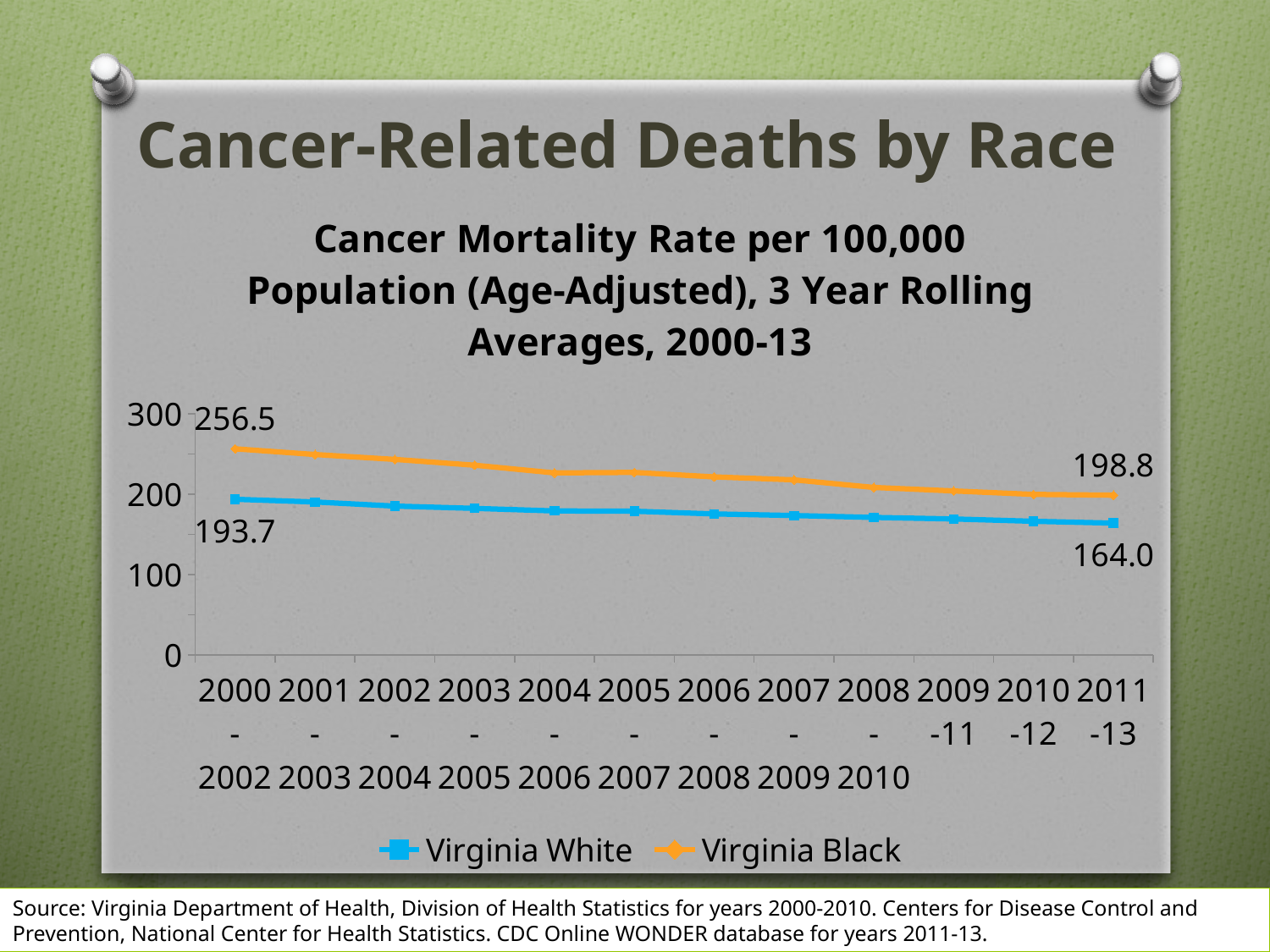
Does the Virginia White series rise or fall from 2000-2002 to 2011-13? fall How many time periods are shown on the x axis? 12 Which series has the higher value in the 2011-13 period, Virginia White or Virginia Black? Virginia Black What is the value for Virginia Black in the 2000-2002 period? 256.5 What is the difference between the Virginia Black and Virginia White values in the 2000-2002 period? 62.8 Is the value for Virginia Black in the 2005-2007 period greater or less than 200? greater What is the value for Virginia Black in the 2011-13 period? 198.8 How many series does the legend list? 2 By how much did the Virginia Black value fall from 2000-2002 to 2011-13? 57.7 What is the value for Virginia White in the 2000-2002 period? 193.7 What is the value for Virginia White in the 2011-13 period? 164.0 By how much did the Virginia White value fall from 2000-2002 to 2011-13? 29.7